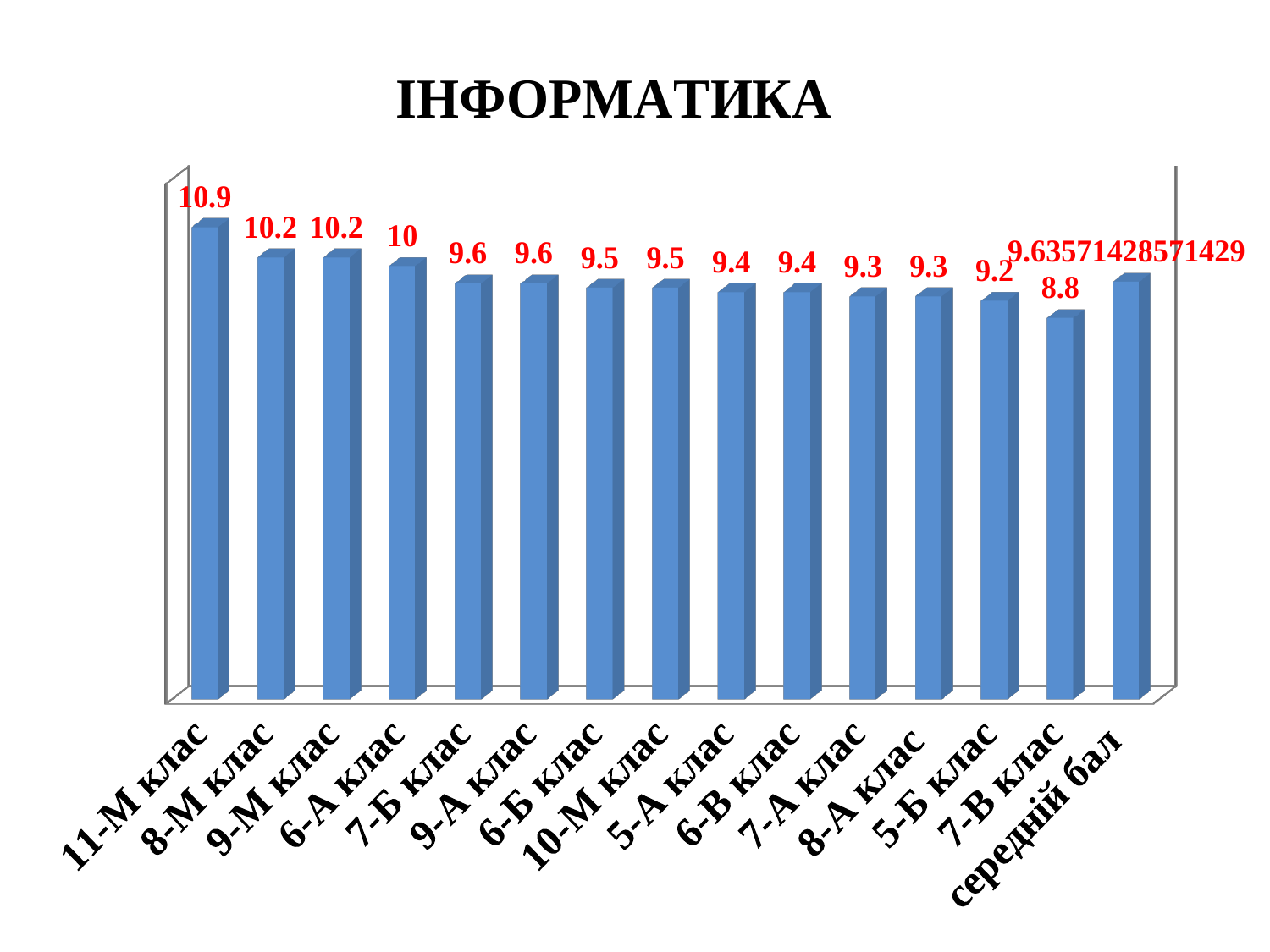
Which category has the highest value? 11-М клас What is the difference between the values for 11-М клас and 7-В клас? 2.1 What is the value for 7-В клас? 8.8 What is the value for 5-Б клас? 9.2 What kind of chart is shown on the slide? Bar chart What is the value shown for середній бал? 9.63571428571429 What is the difference between the values for 8-М клас and 6-А клас? 0.2 Which category has the lowest value? 7-В клас What is the value for 11-М клас? 10.9 What is the title of the chart? ІНФОРМАТИКА Which is larger, the value for 6-А клас or the value for 5-Б клас? 6-А клас How many bars are shown in the chart? 15